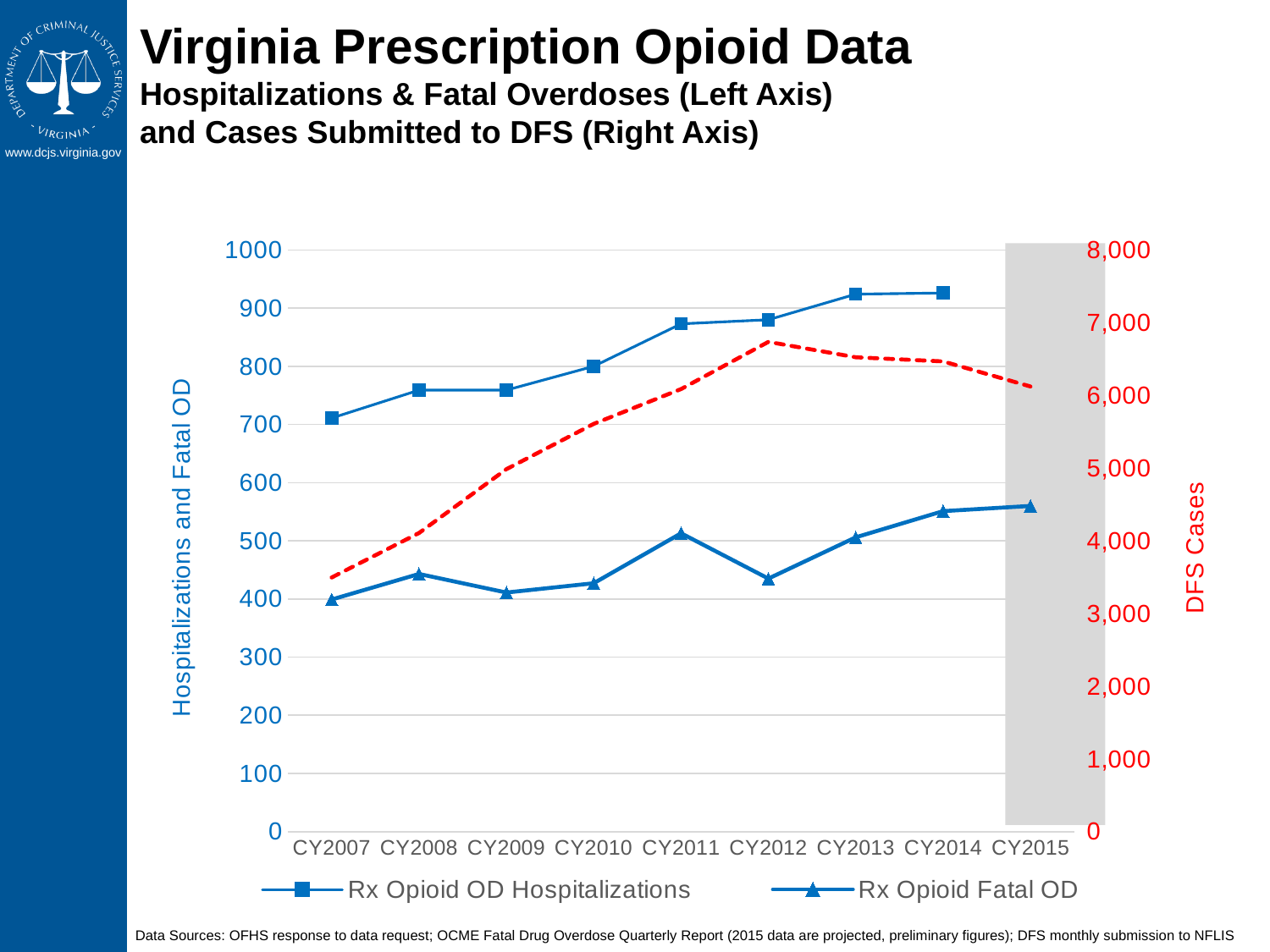
How many series does the legend list? 2 Is the value for Rx Opioid OD Hospitalizations in CY2014 greater or less than 900? greater What kind of chart is shown on the slide? line chart Is the value for Rx Opioid Fatal OD in CY2009 greater or less than 500? less In which year is the Rx Opioid OD Hospitalizations value lowest? CY2007 Does the Rx Opioid OD Hospitalizations series generally rise or fall from CY2007 to CY2014? rise Is the value for Rx Opioid OD Hospitalizations in CY2007 greater or less than 600? greater How many calendar-year categories are shown on the x axis? 9 Which is larger for Rx Opioid Fatal OD: the value in CY2011 or the value in CY2012? CY2011 What is the title of the left vertical axis? Hospitalizations and Fatal OD What is the highest tick value shown on the right axis (DFS Cases)? 8,000